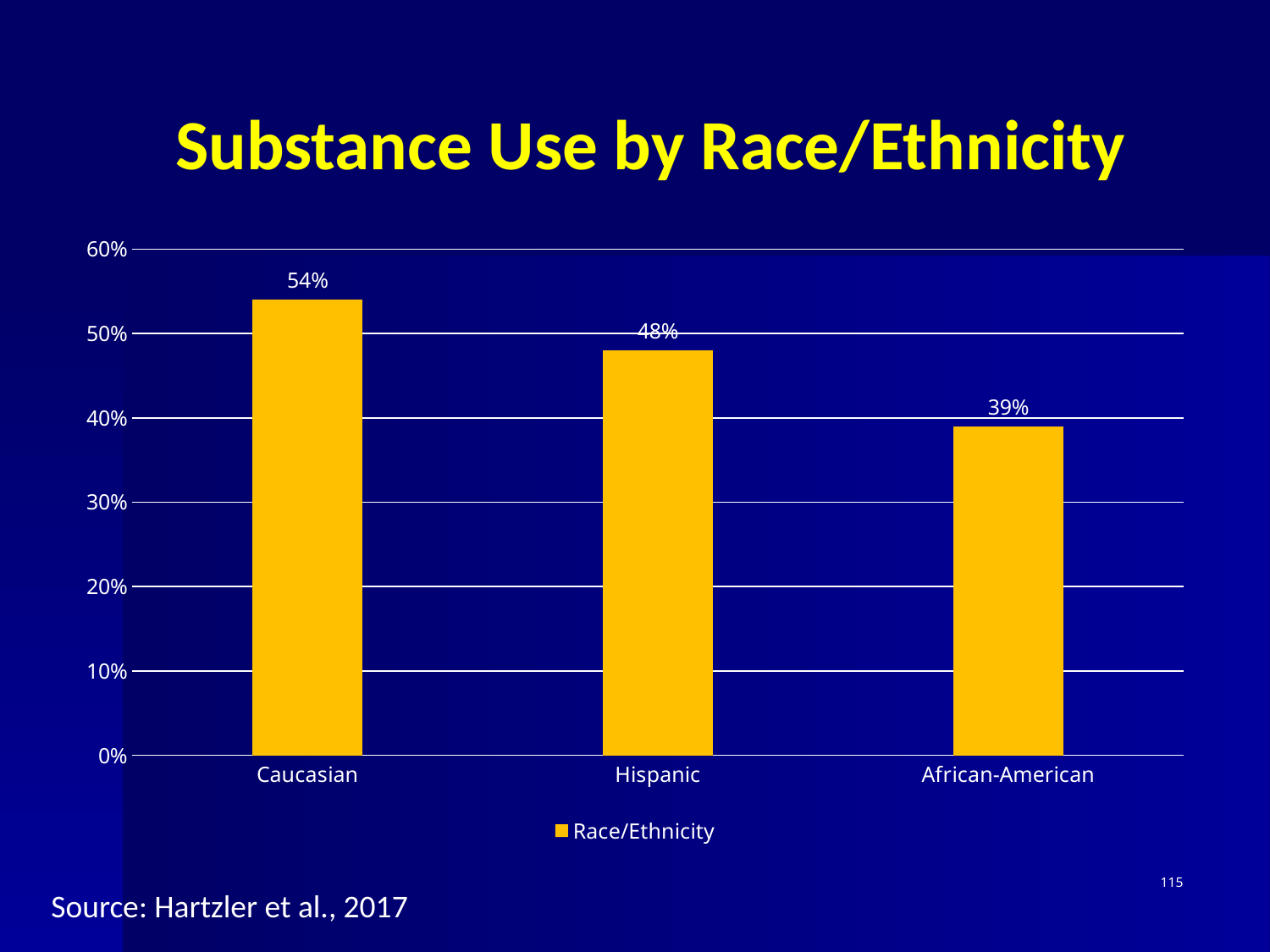
What is the title of the chart? Substance Use by Race/Ethnicity How many categories are shown on the x axis? 3 What is the value for Hispanic? 48% What is the difference between the values for Caucasian and African-American? 15% Which category has the lowest value? African-American What is the value for Caucasian? 54% Which is larger, the value for Hispanic or the value for African-American? Hispanic Which category has the highest value? Caucasian What is the value for African-American? 39% What is the difference between the values for Caucasian and Hispanic? 6% Is the value for Hispanic greater or less than 40%? greater What kind of chart is shown on the slide? Bar chart